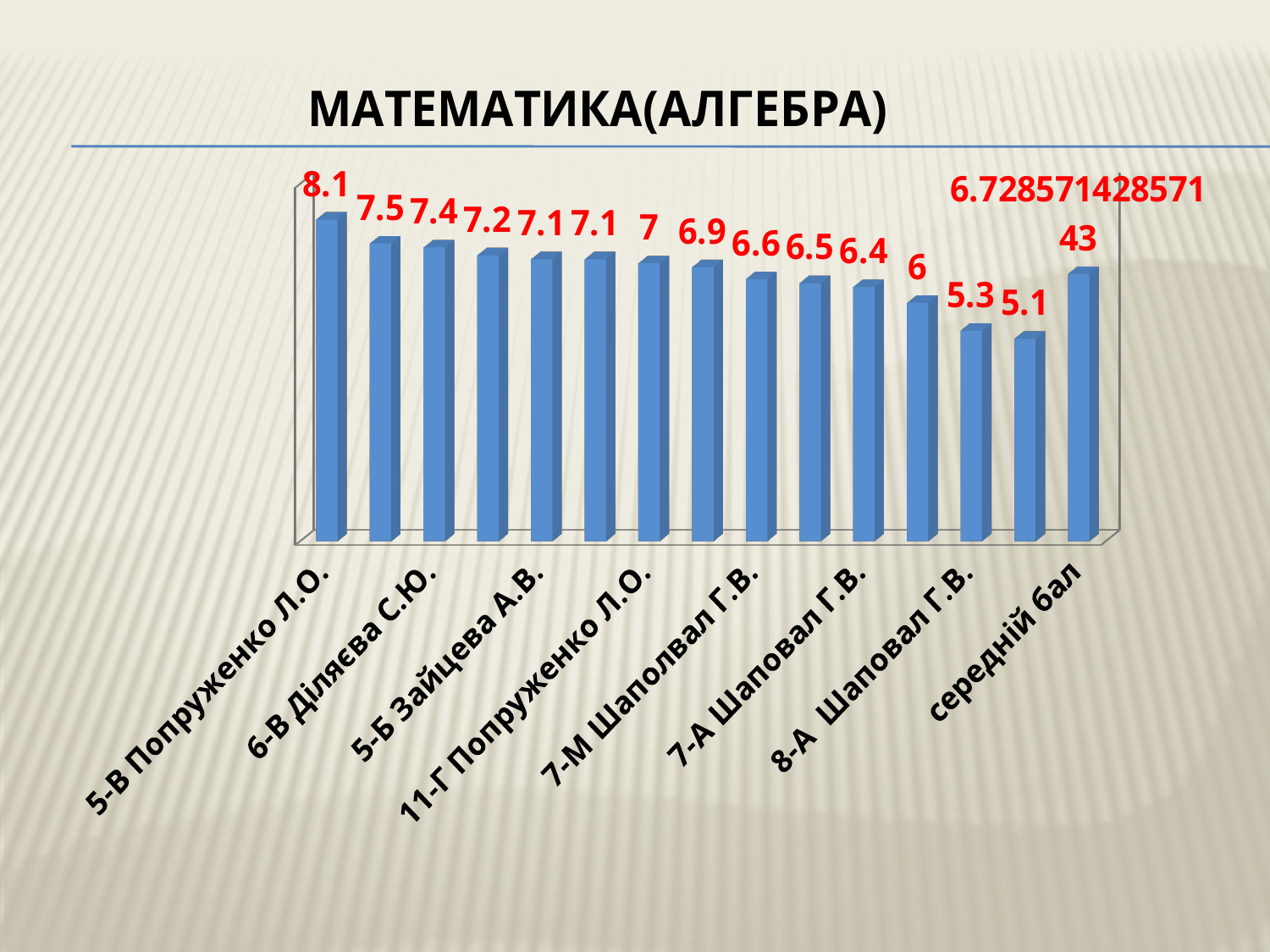
Which category has the highest value? 5-В Попруженко Л.О. What kind of chart is shown on the slide? bar chart What is the value for 8-А Шаповал Г.В.? 5.3 What is the value for 11-Г Попруженко Л.О.? 7 Which is larger, the value for 6-В Діляєва С.Ю. or the value for 7-А Шаповал Г.В.? 6-В Діляєва С.Ю. What is the value for 6-В Діляєва С.Ю.? 7.4 How many bars are plotted on the chart? 15 What is the difference between the values for 5-В Попруженко Л.О. and 6-В Діляєва С.Ю.? 0.7 What is the value shown for середній бал? 6.72857142857143 What is the smallest data label shown on the chart? 5.1 What is the value for 5-В Попруженко Л.О.? 8.1 What is the title of the chart? МАТЕМАТИКА(АЛГЕБРА)